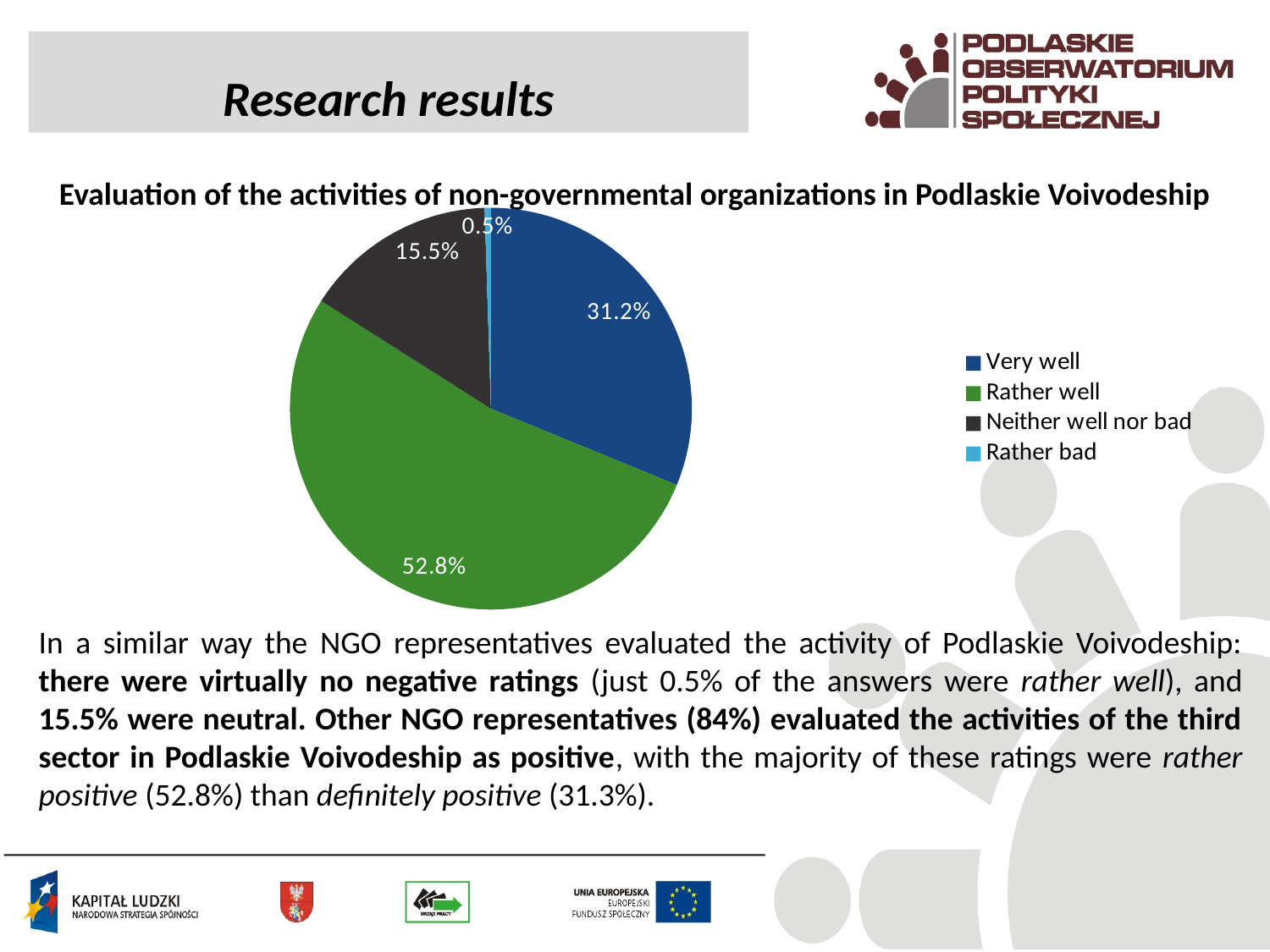
What share of the pie is labelled "Rather well"? 52.8% What share of the pie is labelled "Neither well nor bad"? 15.5% What is the title of the chart? Evaluation of the activities of non-governmental organizations in Podlaskie Voivodeship What kind of chart is shown on the slide? pie chart What share of the pie is labelled "Very well"? 31.2% Which is larger, the "Very well" share or the "Neither well nor bad" share? Very well What is the difference between the "Rather well" and "Very well" shares? 21.6% What share of the pie is labelled "Rather bad"? 0.5% Which category has the largest slice of the pie? Rather well How many categories does the legend list? 4 Which category has the smallest slice of the pie? Rather bad What colour is the "Rather well" slice? green